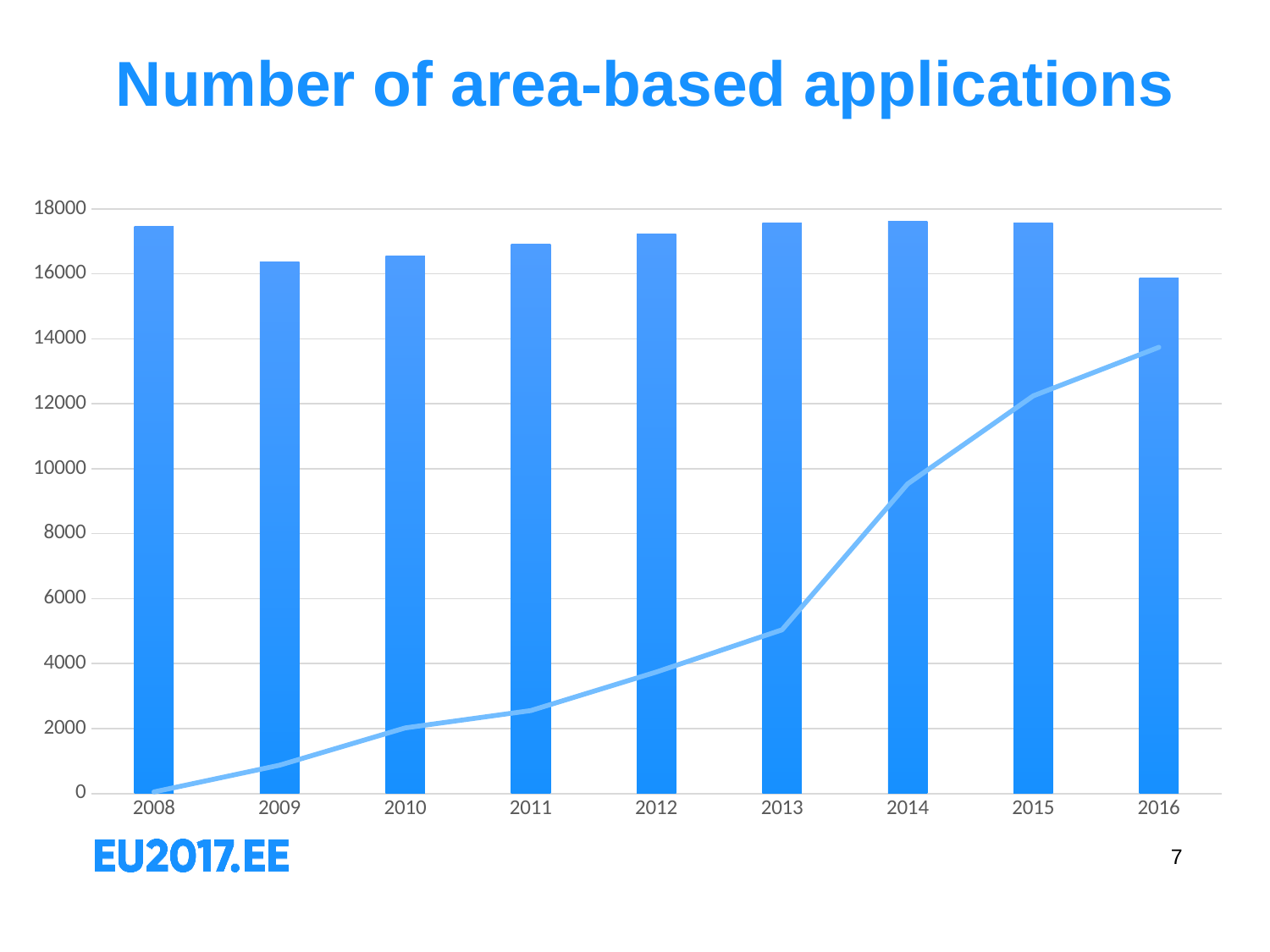
Which is larger, the line value for 2016 or the bar value for 2016? the bar value Is the bar value for 2008 greater or less than 16000? greater Does the line rise or fall from 2008 to 2016? rises Which year has the lowest bar in the chart? 2016 What kind of chart is shown on the slide? A bar chart combined with a line How many years are shown on the x axis of the chart? 9 Is the bar value for 2009 greater or less than 18000? less Is the line value for 2013 greater or less than 6000? less Which is larger, the bar for 2008 or the bar for 2009? 2008 What is the title of the chart? Number of area-based applications